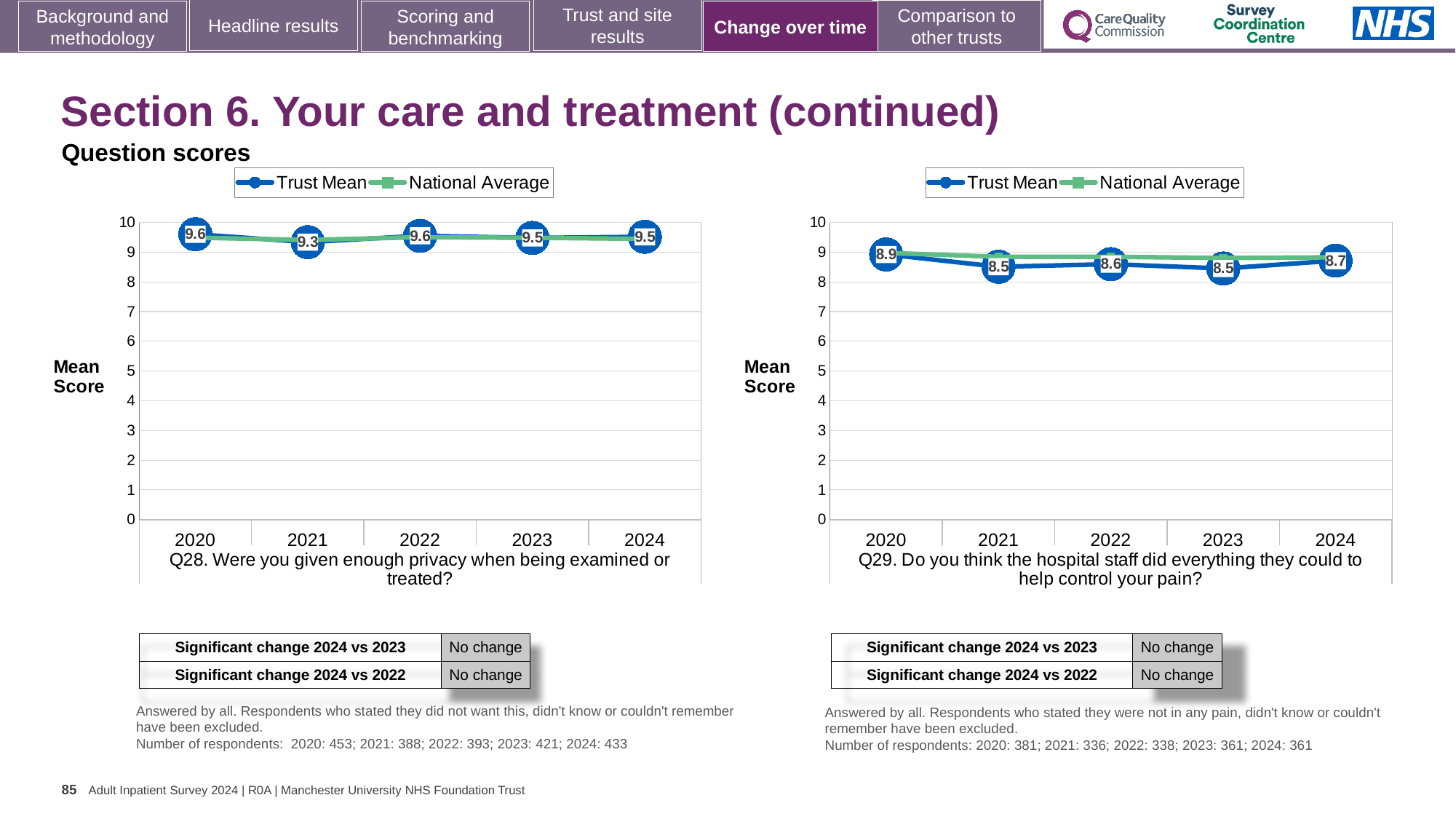
In the Q29 chart (right), what is the difference between the Trust Mean scores for 2020 and 2024? 0.2 What type of chart is used for Q28 (left)? Line chart In the Q28 chart (left), what is the difference between the Trust Mean scores for 2020 and 2021? 0.3 In the Q29 chart (right), what is the Trust Mean score for 2024? 8.7 In the Q28 chart (left), which year has the lowest Trust Mean score? 2021 In the Q29 chart (right), is the National Average value for 2021 greater or less than 8? greater How many series does the legend of the Q29 chart (right) list? 2 In the Q29 chart (right), which year has the highest Trust Mean score? 2020 In the Q29 chart (right), is the Trust Mean score higher in 2020 or in 2021? 2020 In the Q29 chart (right), does the Trust Mean score rise or fall from 2020 to 2021? Fall In the Q28 chart (left), what is the Trust Mean score for 2021? 9.3 How many years are plotted on the x axis of the Q28 chart (left)? 5